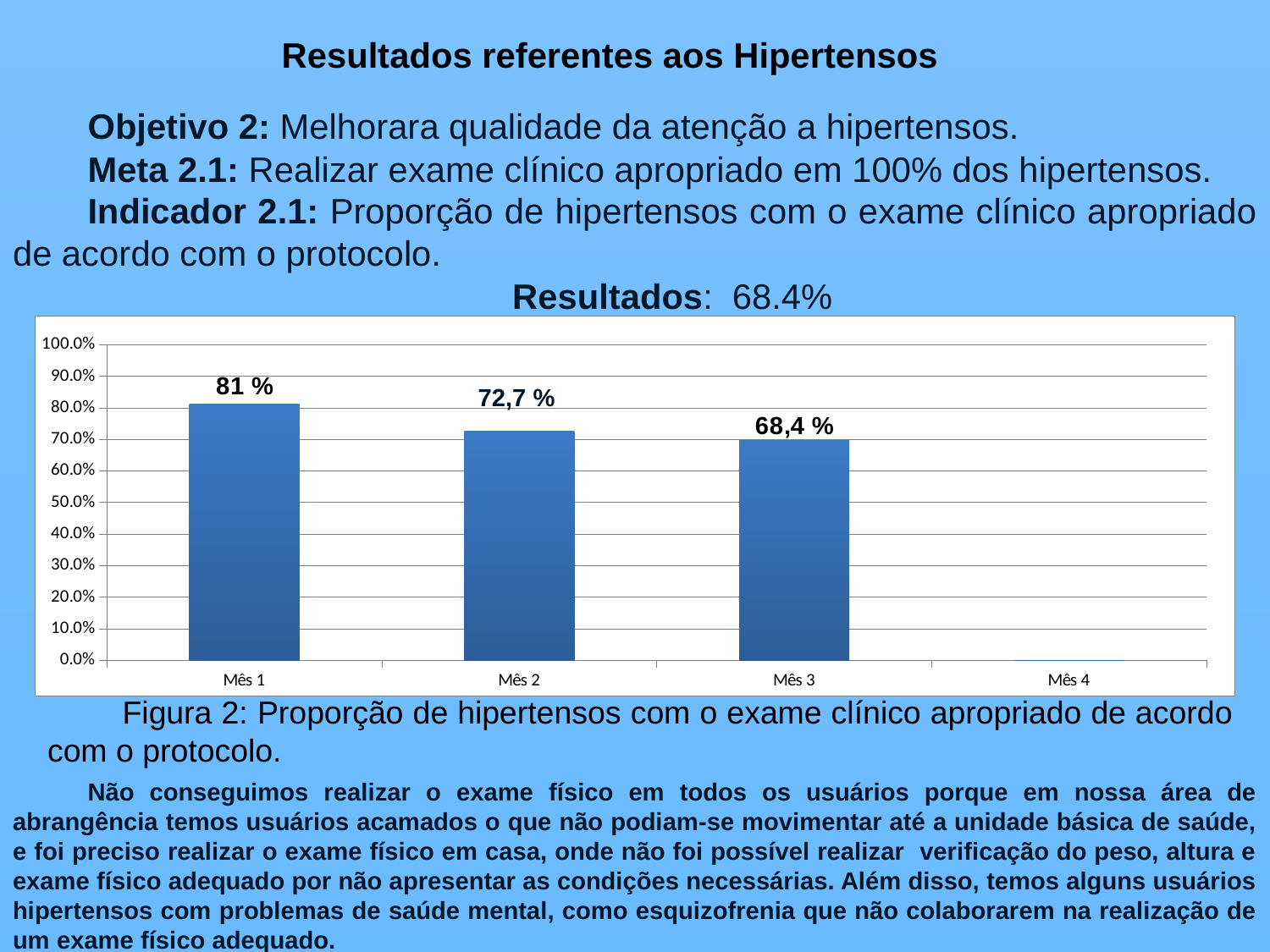
What is the value shown for Mês 2? 72,7 % What is the value shown for Mês 1? 81 % Do the values rise or fall from Mês 1 to Mês 3? fall What is the value shown for Mês 3? 68,4 % What kind of chart is shown on the slide? bar chart How many month categories are shown on the x axis? 4 What is the difference between the values for Mês 1 and Mês 3? 12,6 % Which month has the highest bar? Mês 1 Which is larger, the value for Mês 2 or the value for Mês 3? Mês 2 Is the value for Mês 2 greater or less than 80.0%? less Among the three bars with data labels, which month has the lowest value? Mês 3 What is the difference between the values for Mês 1 and Mês 2? 8,3 %